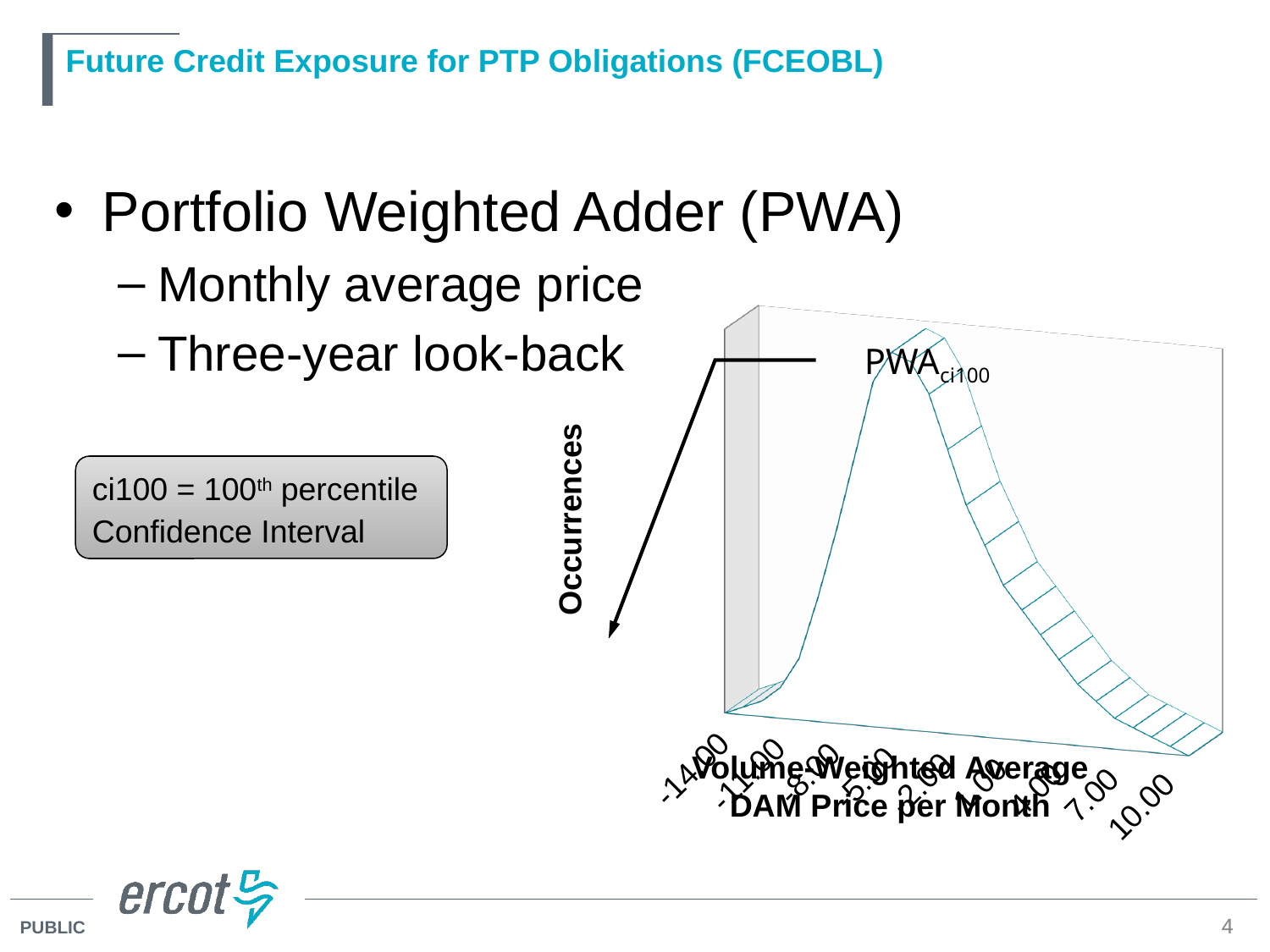
What is the lowest value shown on the x axis of the chart? -14.00 What is the title of the vertical axis of the chart? Occurrences What is the highest value shown on the x axis of the chart? 10.00 What kind of chart is shown on the slide? 3D area chart Do the occurrences rise or fall as the DAM price moves from 1.00 toward 10.00 on the x axis? fall What label is attached to the peak of the curve in the chart? PWAci100 Is the number of occurrences at a DAM price of 10.00 higher or lower than at the peak labelled PWAci100? lower